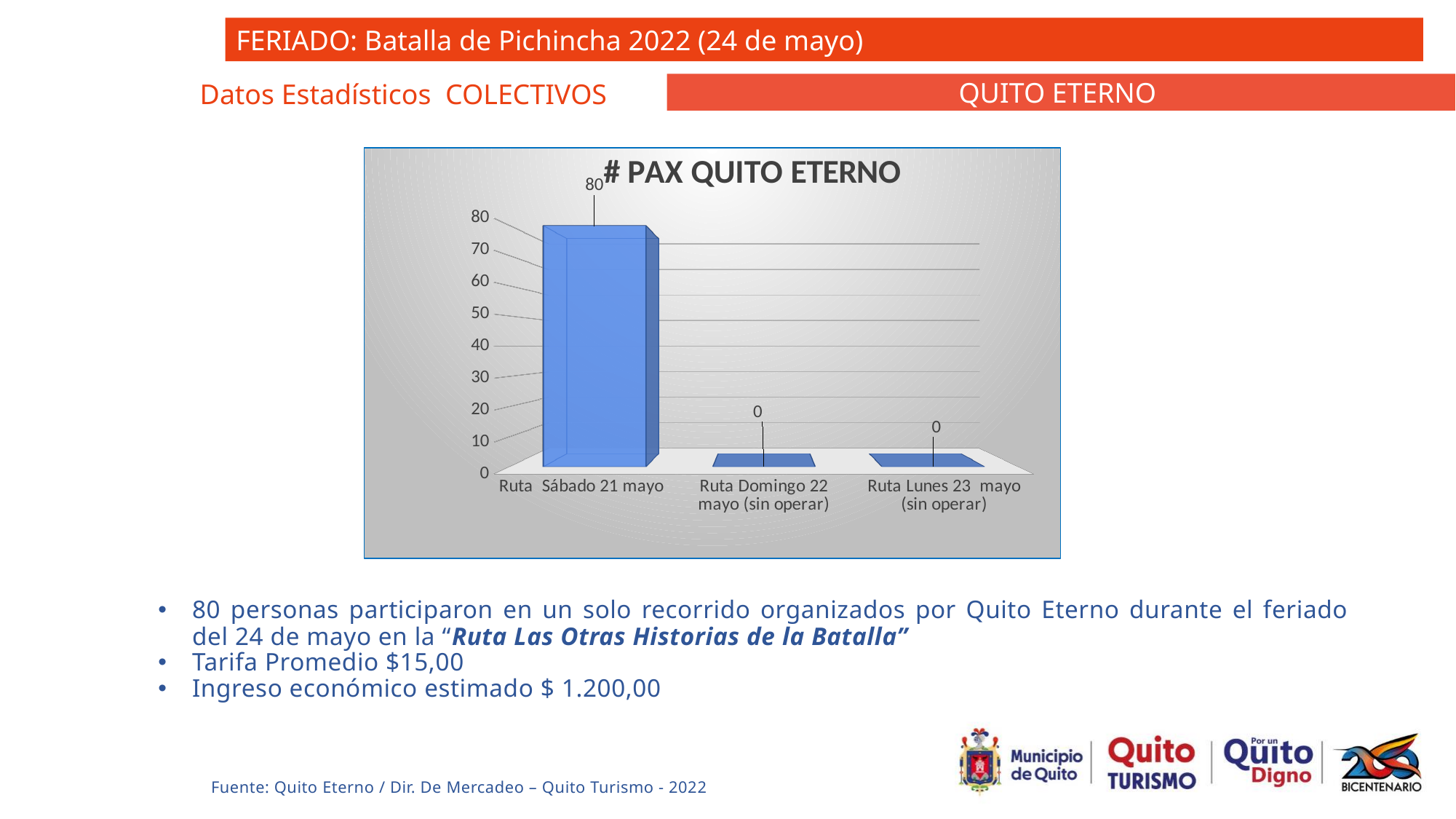
What is the difference between the value for Ruta Sábado 21 mayo and the value for Ruta Domingo 22 mayo (sin operar)? 80 Which category has the highest value? Ruta Sábado 21 mayo What is the title of the chart? # PAX QUITO ETERNO What is the value for Ruta Domingo 22 mayo (sin operar)? 0 What is the highest value shown on the vertical axis? 80 What is the value for Ruta Sábado 21 mayo? 80 What is the value for Ruta Lunes 23 mayo (sin operar)? 0 How many categories are shown on the x axis? 3 Do the values rise or fall from the first category to the last along the x axis? fall Is the value for Ruta Sábado 21 mayo greater or less than 50? greater What kind of chart is shown on the slide? bar chart Which is larger, the value for Ruta Sábado 21 mayo or the value for Ruta Lunes 23 mayo (sin operar)? Ruta Sábado 21 mayo